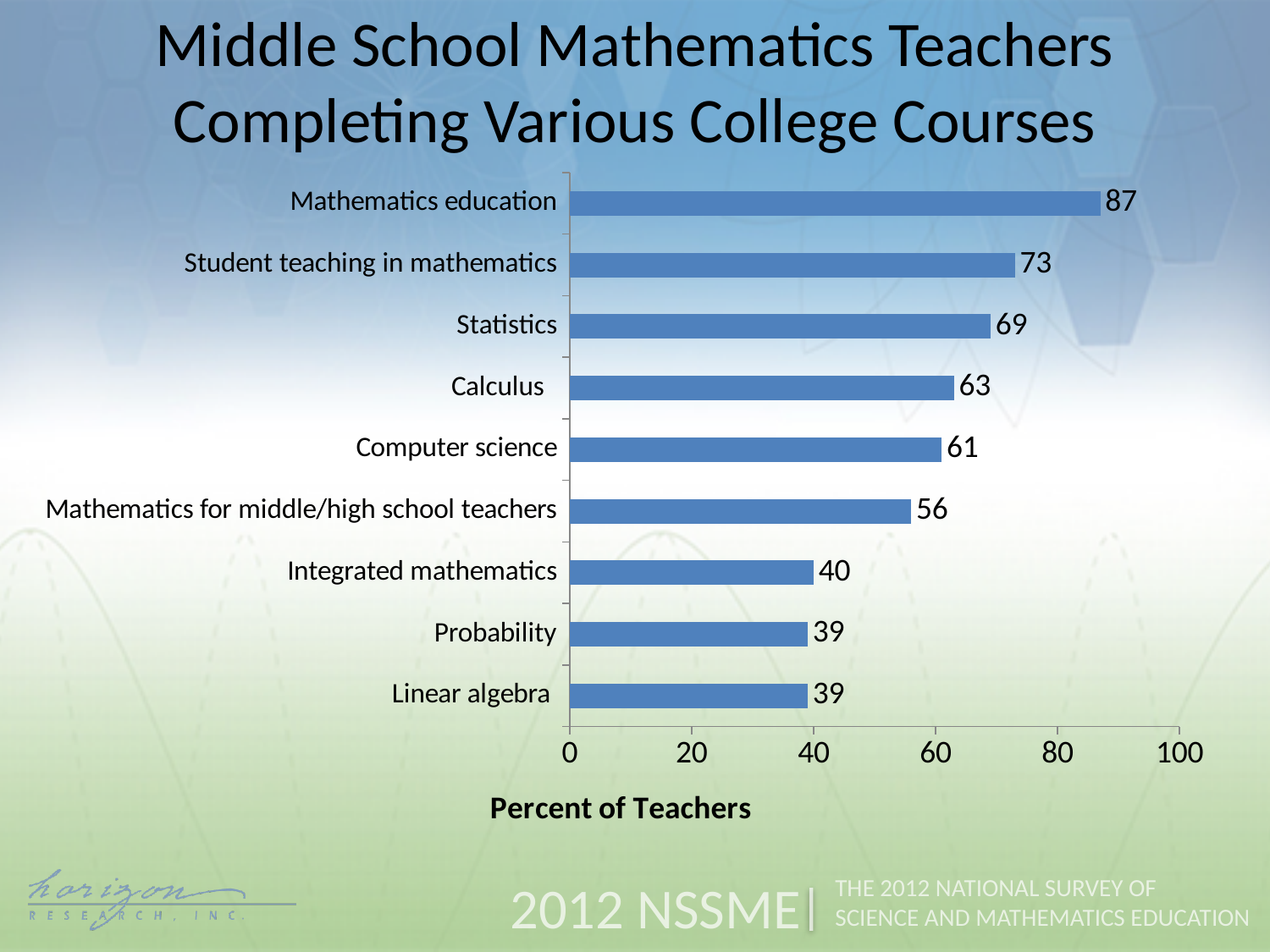
What is the difference between the values for Statistics and Calculus? 6 What percent of teachers completed a Mathematics education course? 87 What is the label of the horizontal axis? Percent of Teachers Which course has the highest percent of teachers? Mathematics education What is the difference between the values for Mathematics education and Student teaching in mathematics? 14 What kind of chart is shown on the slide? bar chart Which is larger, the value for Calculus or the value for Computer science? Calculus How many courses are listed on the chart? 9 What is the value for Mathematics for middle/high school teachers? 56 What is the lowest value shown on the chart? 39 Is the value for Integrated mathematics greater or less than 60? less What is the value for Computer science? 61